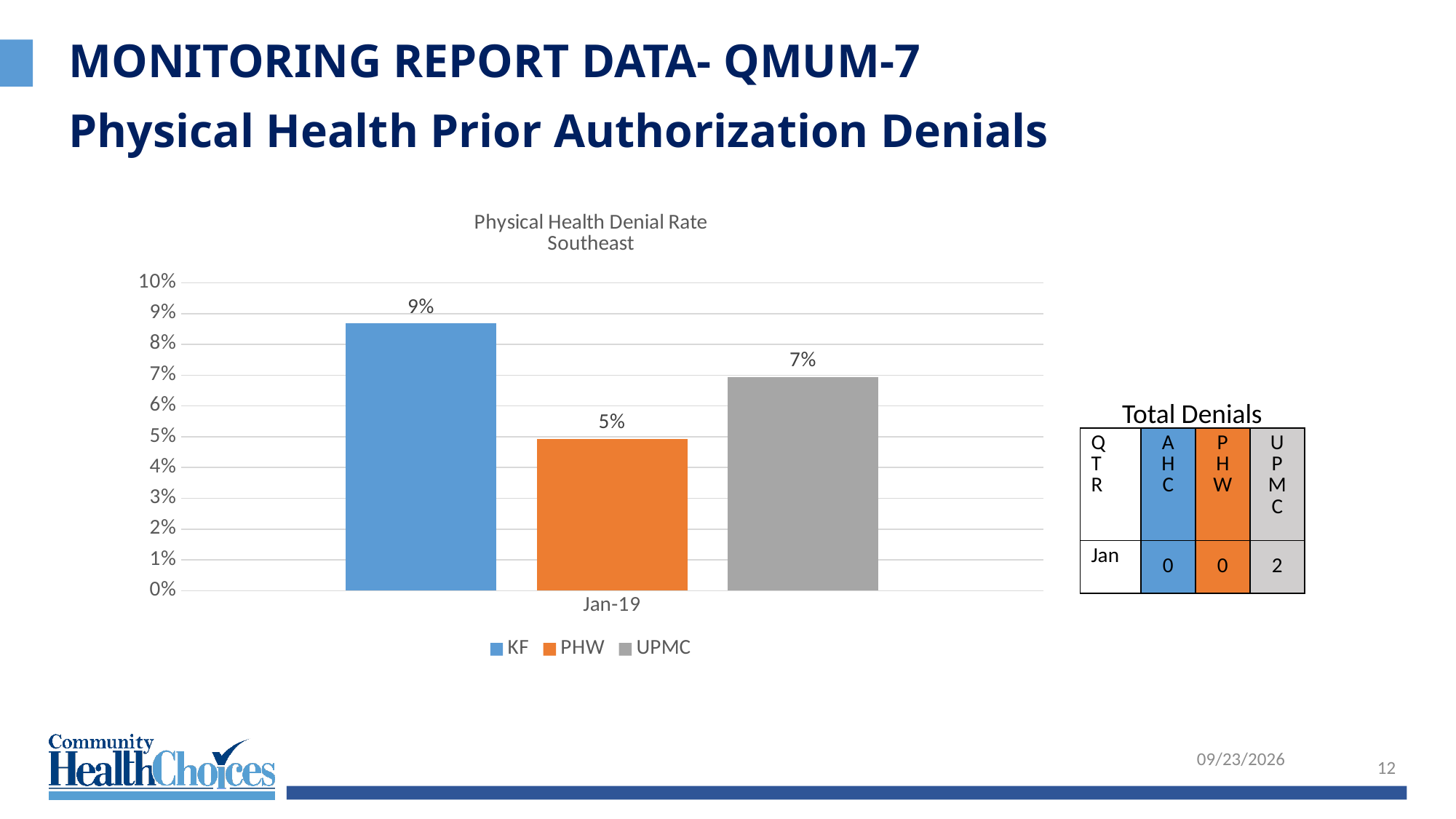
Which series has the lowest denial rate in Jan-19? PHW Which has a higher denial rate in Jan-19, UPMC or PHW? UPMC What is the denial rate for UPMC in Jan-19? 7% What is the denial rate for PHW in Jan-19? 5% How many series does the legend list? 3 What kind of chart is shown on the slide? bar chart Which series has the highest denial rate in Jan-19? KF What is the denial rate for KF in Jan-19? 9% Is the denial rate for UPMC greater or less than 8%? less What is the difference between the KF and PHW denial rates in Jan-19? 4% How many categories are shown on the x axis? 1 What is the title of the chart? Physical Health Denial Rate Southeast